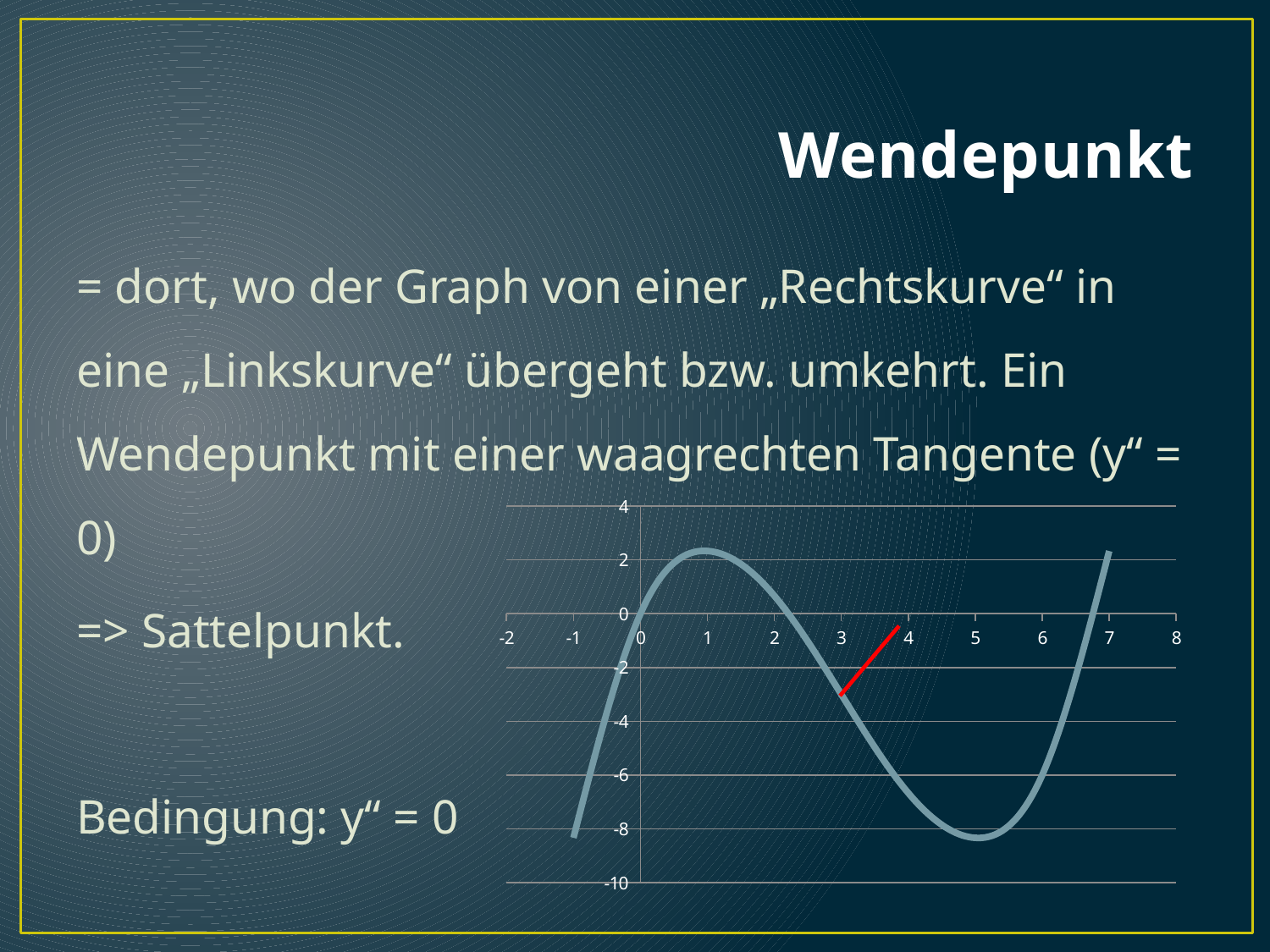
Is the value of the curve at x = 7 greater or less than 0? greater Is the value of the curve at x = 5 greater or less than -6? less Does the curve rise or fall between x = 1 and x = 5? fall Is the value of the curve at x = 1 greater or less than 0? greater What kind of chart is shown on the slide? line chart How many labels are shown on the x axis? 11 Does the curve rise or fall between x = 5 and x = 7? rise Which is larger, the value of the curve at x = 1 or at x = 5? x = 1 What are the lowest and highest values labelled on the y axis? -10 and 4 What colour is the short tangent line segment drawn on the curve? red Near which x-axis label does the curve reach its lowest point? 5